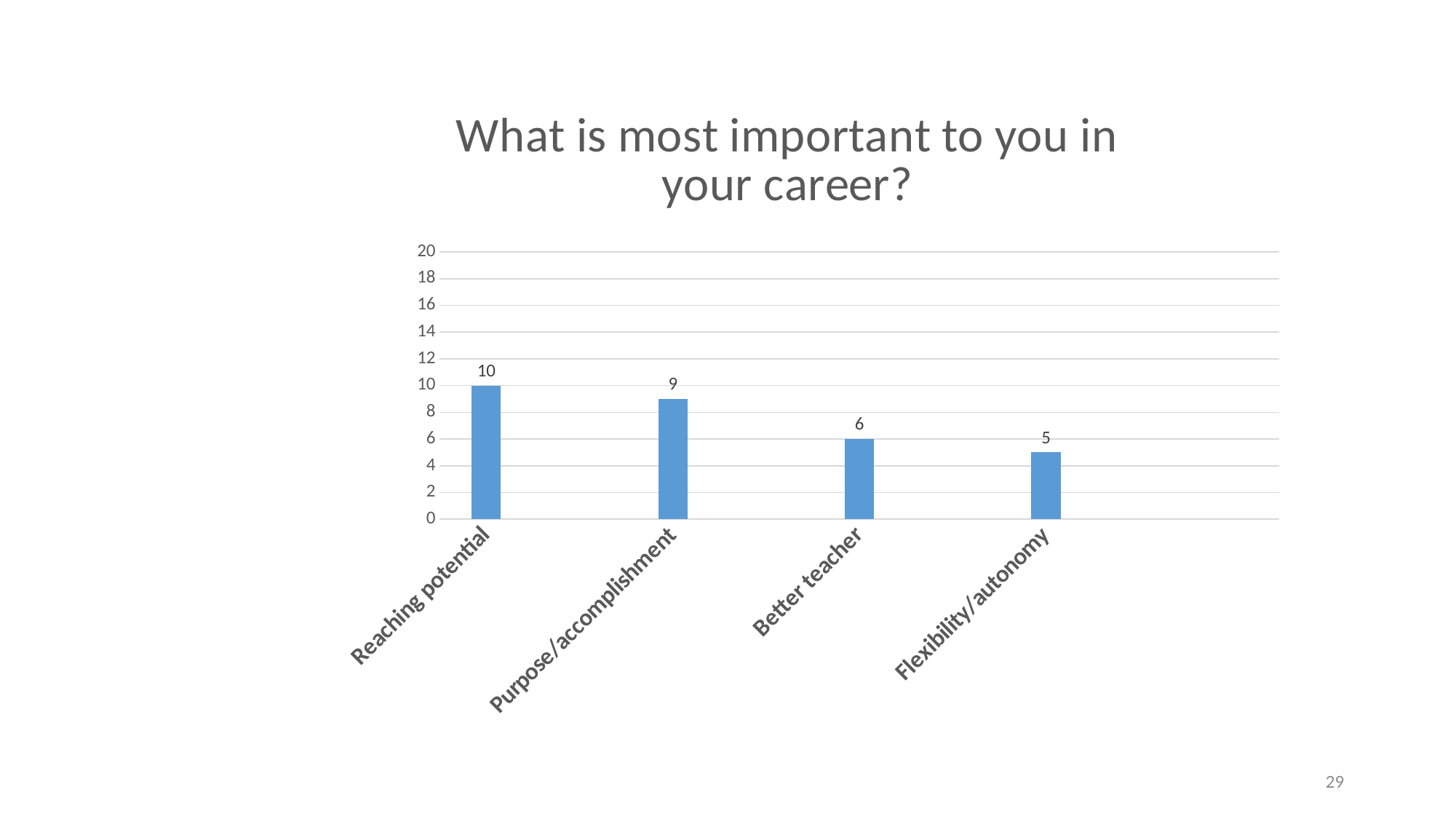
Is the value for Better teacher greater or less than 8? less What is the value for Purpose/accomplishment? 9 Which category has the lowest value? Flexibility/autonomy What is the difference between the values for Reaching potential and Better teacher? 4 Which category has the highest value? Reaching potential What is the value for Flexibility/autonomy? 5 How many categories are shown on the chart? 4 What kind of chart is shown on the slide? bar chart What is the value for Better teacher? 6 What is the value for Reaching potential? 10 What is the title of the chart? What is most important to you in your career? Which is larger, the value for Purpose/accomplishment or the value for Flexibility/autonomy? Purpose/accomplishment